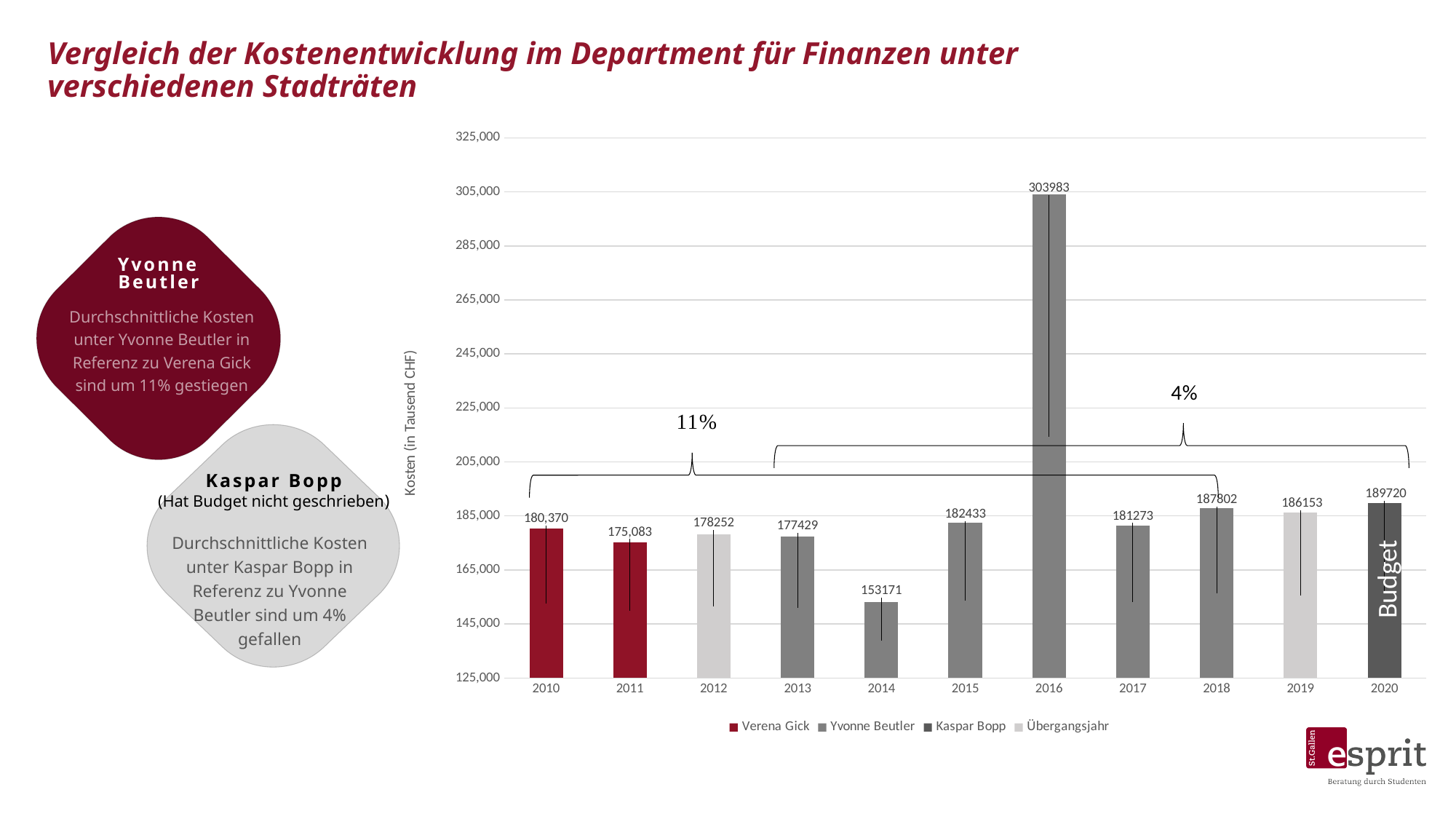
What is the value for 2014? 153171 Is the value for 2014 greater or less than 165,000? less What is the value for 2020? 189720 What is the value for 2016? 303983 What is the value for 2010? 180,370 What kind of chart is shown? bar chart Which is larger, the value for 2015 or the value for 2017? 2015 Which year has the highest value? 2016 How many years are shown on the x axis? 11 What is the difference between the values for 2018 and 2019? 1649 How many series does the legend list? 4 Which year has the lowest value? 2014